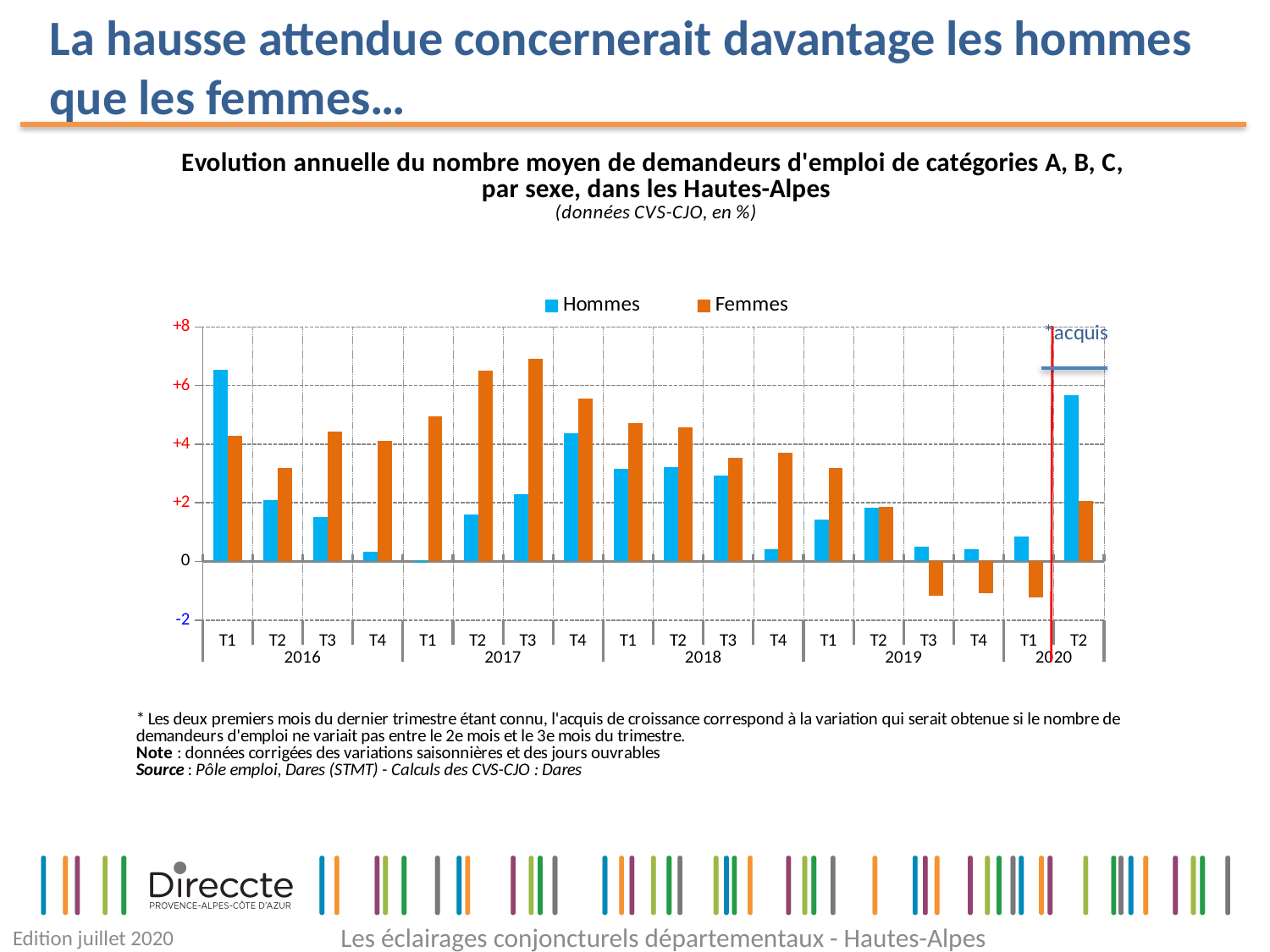
What colour represents the Femmes series? Orange Is the Hommes value for T2 2020 greater or less than +4? greater In which quarter is the Hommes value highest? T1 2016 Is the Femmes value for T3 2019 greater or less than 0? less How many series does the legend list? 2 In T2 2017, which series has the larger value, Hommes or Femmes? Femmes Which two series are shown in the legend? Hommes and Femmes In T2 2020, which series has the larger value, Hommes or Femmes? Hommes Is the Femmes value for T3 2017 greater or less than +6? greater How many quarters are plotted along the x axis? 18 What kind of chart is shown on the slide? Bar chart How many quarters show a negative value for Femmes? 3